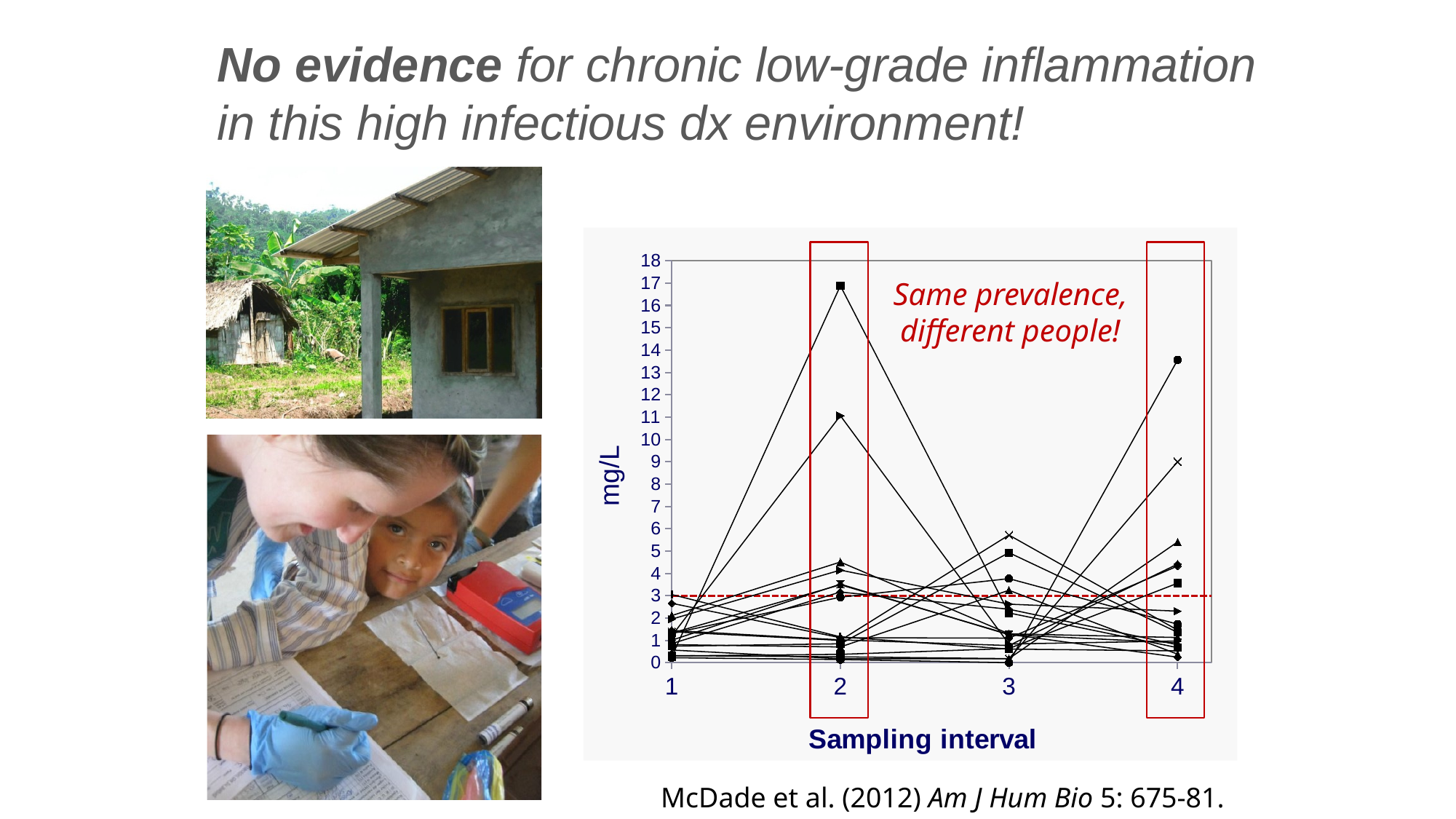
Is the highest value at sampling interval 3 greater or less than 8 mg/L? less Is the highest value at sampling interval 4 greater or less than 12 mg/L? greater What kind of chart is shown on the slide? line chart At which sampling interval does the single highest value in the chart occur? 2 Is the highest value at sampling interval 2 greater or less than 15 mg/L? greater What is the label of the y axis of the chart? mg/L What is the label of the x axis of the chart? Sampling interval What is the maximum value shown on the y axis of the chart? 18 How many sampling intervals are shown along the x axis? 4 Is the highest value at sampling interval 2 greater than the highest value at sampling interval 4? yes At what mg/L level is the horizontal dashed red line drawn on the chart? 3